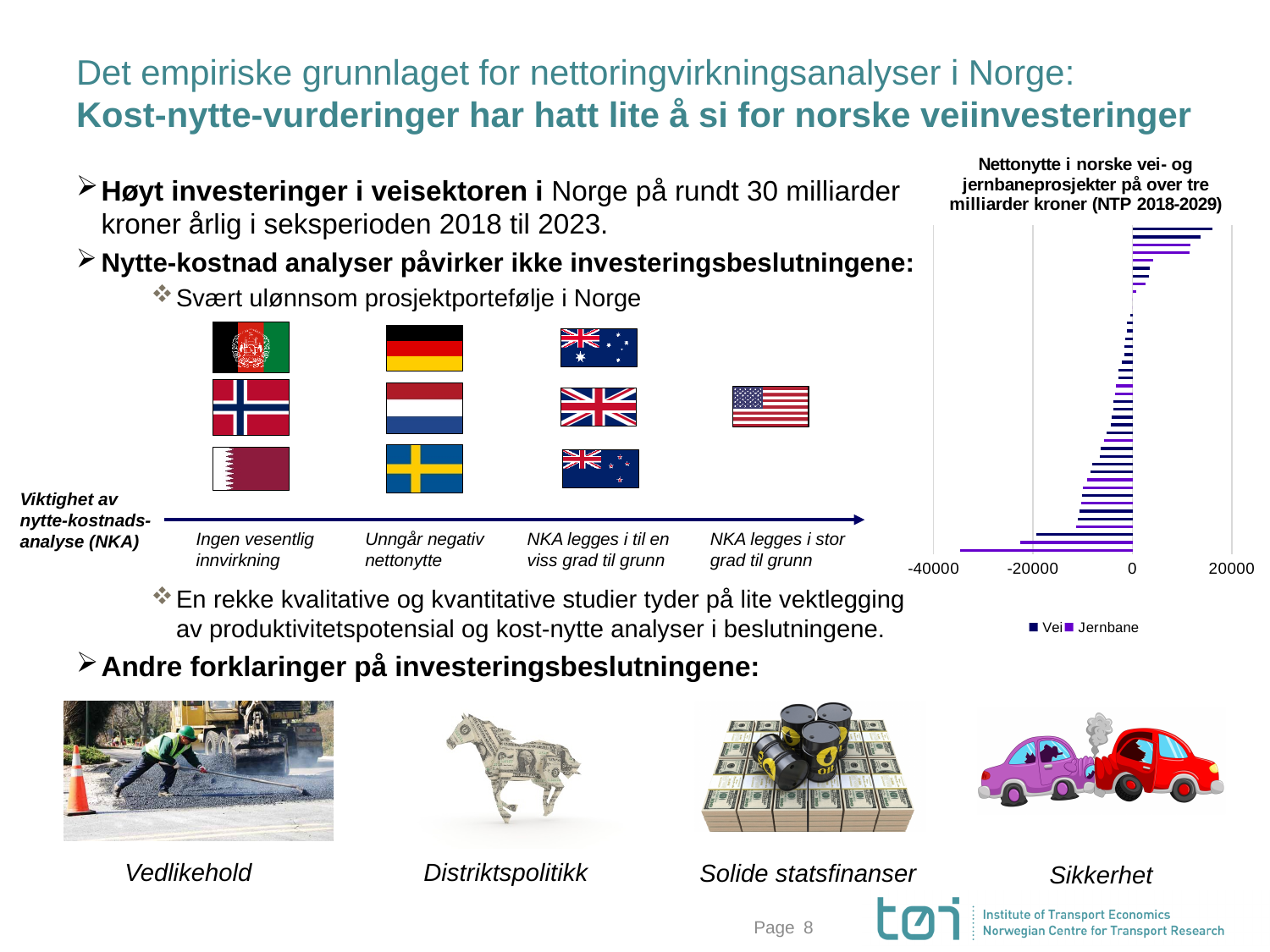
What are the two series named in the chart's legend? Vei and Jernbane Is the value of the bottommost bar in the chart greater or less than 0? less Do the bar values in the chart rise or fall when reading from the top bar to the bottom bar? fall Is the value of the topmost bar in the chart greater or less than 0? greater What is the highest value shown on the chart's horizontal axis? 20000 Are most of the bars in the chart positive or negative? negative What is the title of the chart on the slide? Nettonytte i norske vei- og jernbaneprosjekter på over tre milliarder kroner (NTP 2018-2029) Is the value of the longest positive bar in the chart greater or less than 20000? less What kind of chart is shown on the right side of the slide? Bar chart How many series does the legend of the chart list? 2 What is the lowest value shown on the chart's horizontal axis? -40000